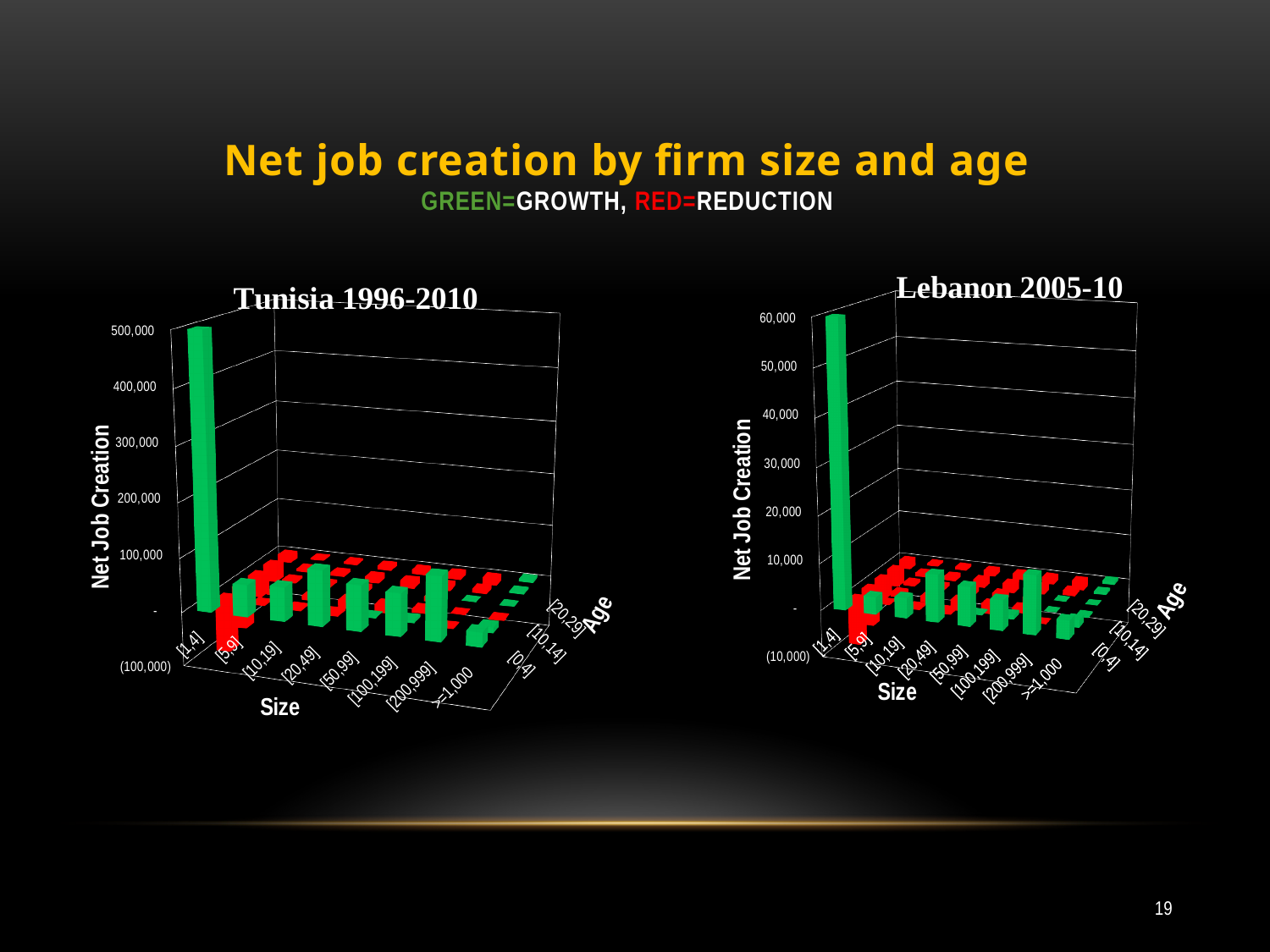
How many firm size categories are shown on the Size axis of the Tunisia 1996-2010 chart? 8 According to the slide subtitle, what do the green bars represent? Growth In the Lebanon 2005-10 chart, is the tallest bar greater or less than 50,000? greater In the Tunisia 1996-2010 chart, which firm size category has the tallest bar? [1,4] How many firm size categories are shown on the Size axis of the Lebanon 2005-10 chart? 8 In the Lebanon 2005-10 chart, is the tallest bar greater or less than 30,000? greater In the Lebanon 2005-10 chart, which firm size category has the tallest bar? [1,4] In the Tunisia 1996-2010 chart, is the tallest bar greater or less than 400,000? greater What kind of chart is the Tunisia 1996-2010 chart? bar chart What is the title of the vertical axis on both charts? Net Job Creation In the Tunisia 1996-2010 chart, is the bar for size [1,4] taller than the bar for size [200,999]? Yes